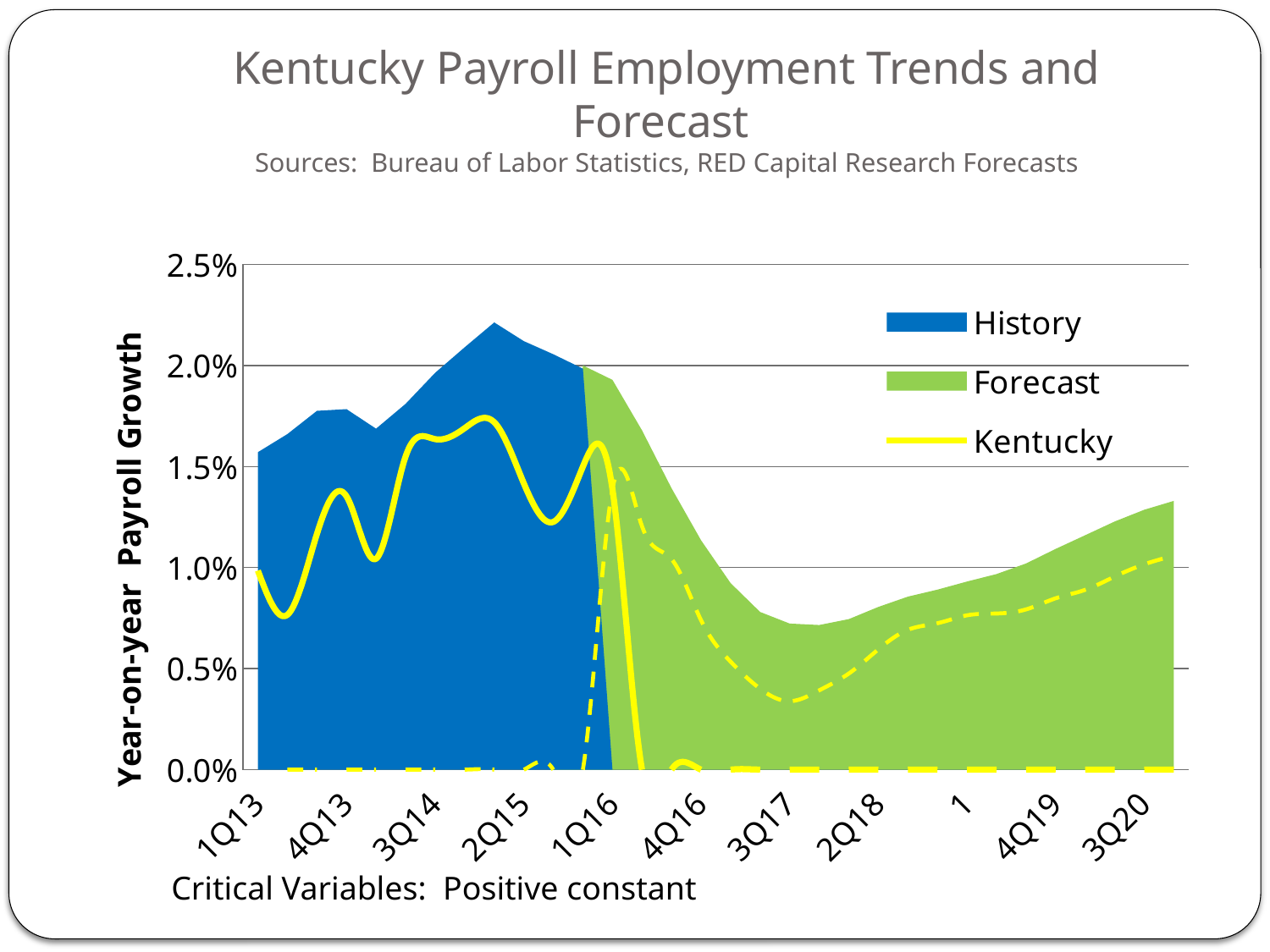
Is the History value at 2Q15 greater or less than 2.0%? greater Which colour represents the Forecast series in the legend? Green Is the Forecast value at 3Q20 greater or less than 1.0%? greater What is the title of the chart? Kentucky Payroll Employment Trends and Forecast At which labelled quarter is the Forecast area at its lowest? 3Q17 Does the Forecast area rise or fall between 4Q16 and 3Q17? Fall Which is larger, the Forecast value at 3Q17 or the Forecast value at 3Q20? 3Q20 How many series does the legend list? 3 Is the History value at 1Q13 greater or less than 1.0%? greater What kind of chart is shown on the slide? Combination area and line chart Does the Forecast area rise or fall between 3Q17 and 3Q20? Rise